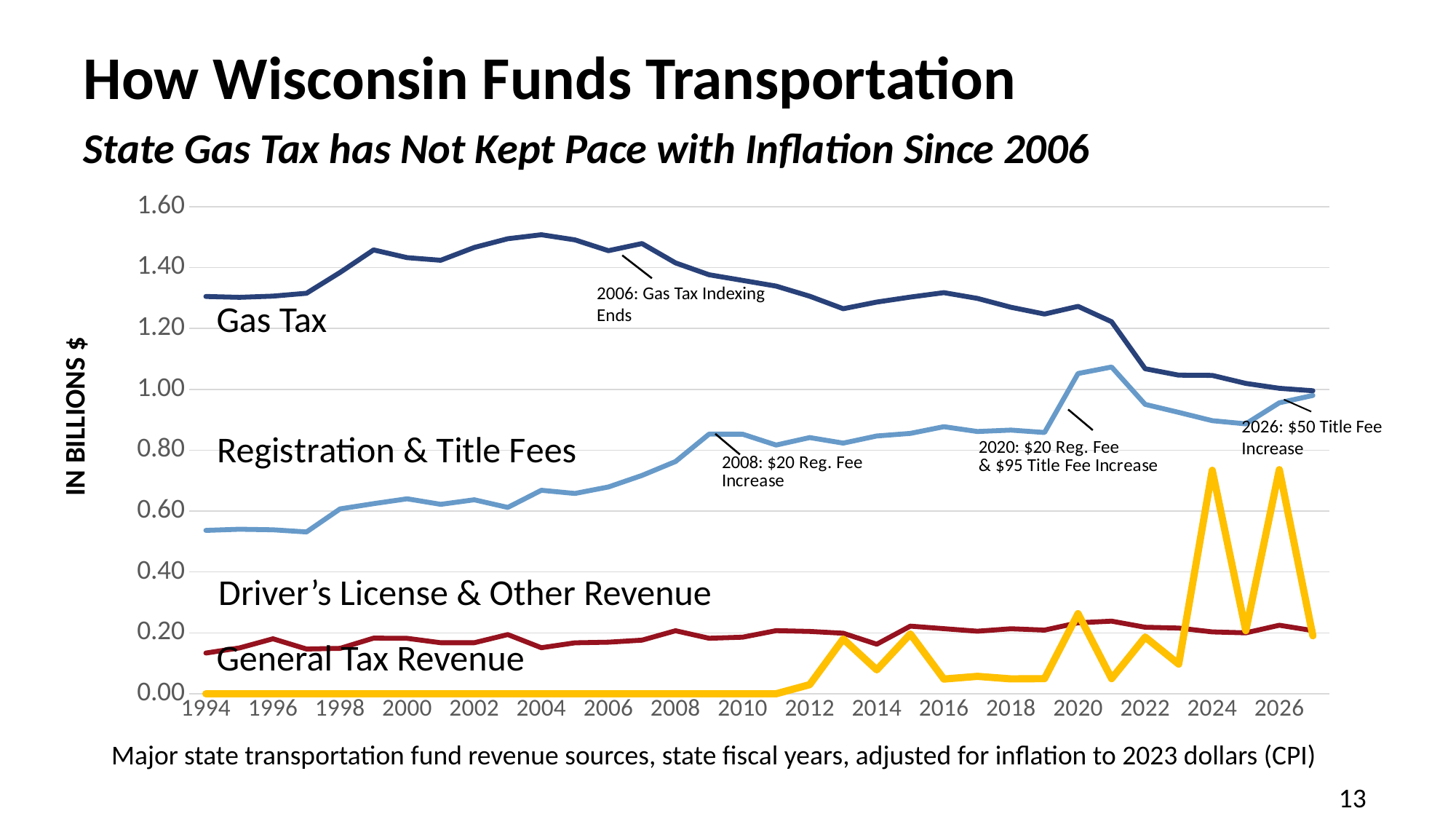
In 2004, which is larger: Gas Tax or Registration & Title Fees? Gas Tax What is the label on the vertical axis? IN BILLIONS $ How many revenue series are plotted on the chart? 4 Is the Registration & Title Fees value for 1994 greater or less than 0.60? less Which revenue source is the highest in 1994? Gas Tax Does the Gas Tax line rise or fall from 2007 to 2027? Fall What kind of chart is shown on the slide? Line chart In 2021, which is larger: Gas Tax or Registration & Title Fees? Gas Tax Is the Registration & Title Fees value for 2021 greater or less than 1.00? greater Is the Gas Tax value for 2004 greater or less than 1.40? greater